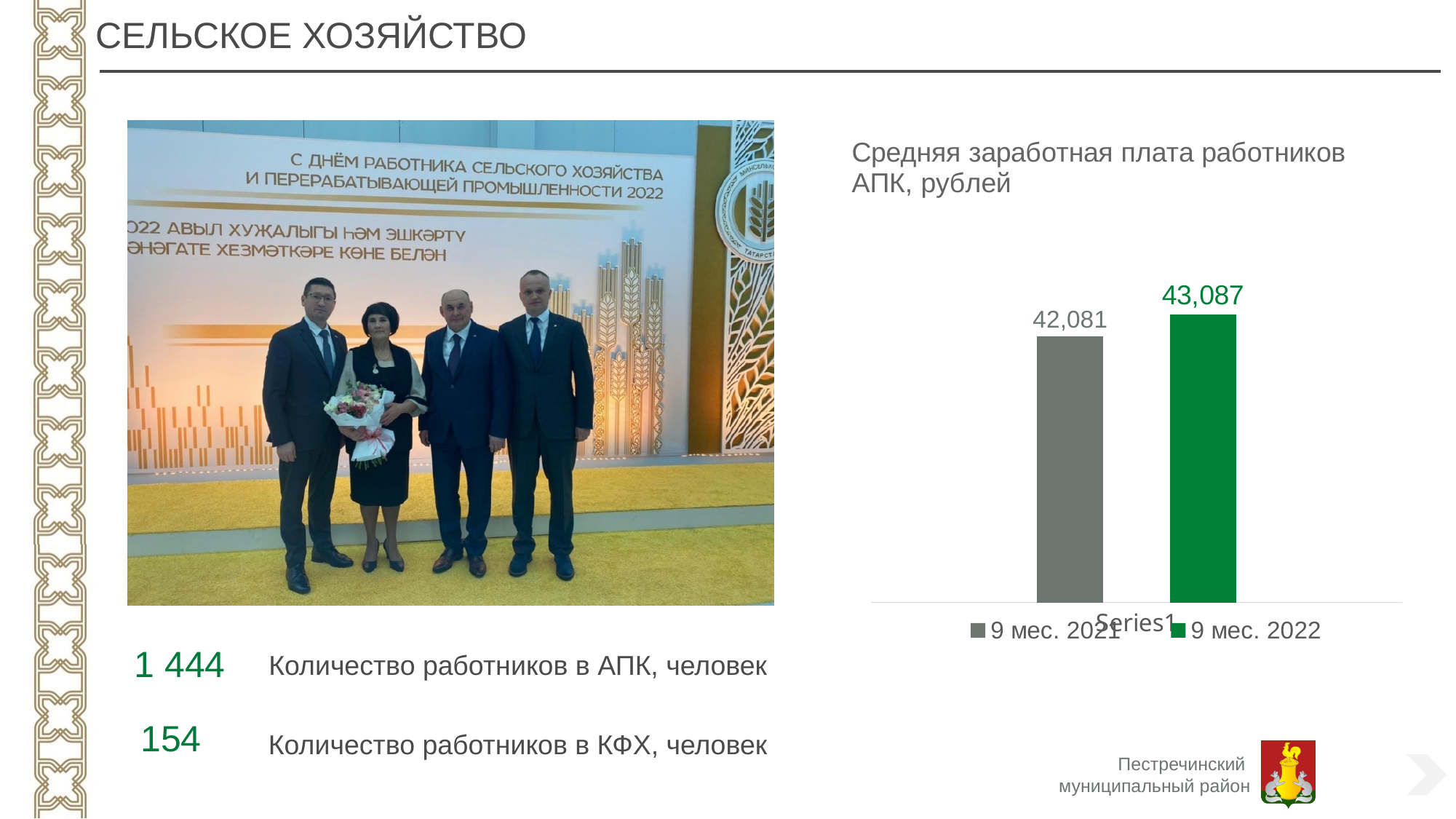
What is the average salary of agro-industrial complex workers for 9 months of 2021 according to the chart? 42,081 Is the average salary for 9 months of 2022 larger or smaller than for 9 months of 2021? larger What is the average salary of agro-industrial complex workers for 9 months of 2022 according to the chart? 43,087 What type of chart is used to show the average salary of agro-industrial complex workers? bar chart What colour is the bar for 9 months of 2022? green Which period shows the lower average salary in the chart? 9 мес. 2021 Does the average salary rise or fall from 9 months of 2021 to 9 months of 2022? rise How many entries does the chart legend list? 2 What is the title of the chart on the slide? Средняя заработная плата работников АПК, рублей Which period shows the higher average salary in the chart? 9 мес. 2022 How many bars are plotted in the chart? 2 By how much did the average salary for 9 months of 2022 exceed that for 9 months of 2021? 1,006